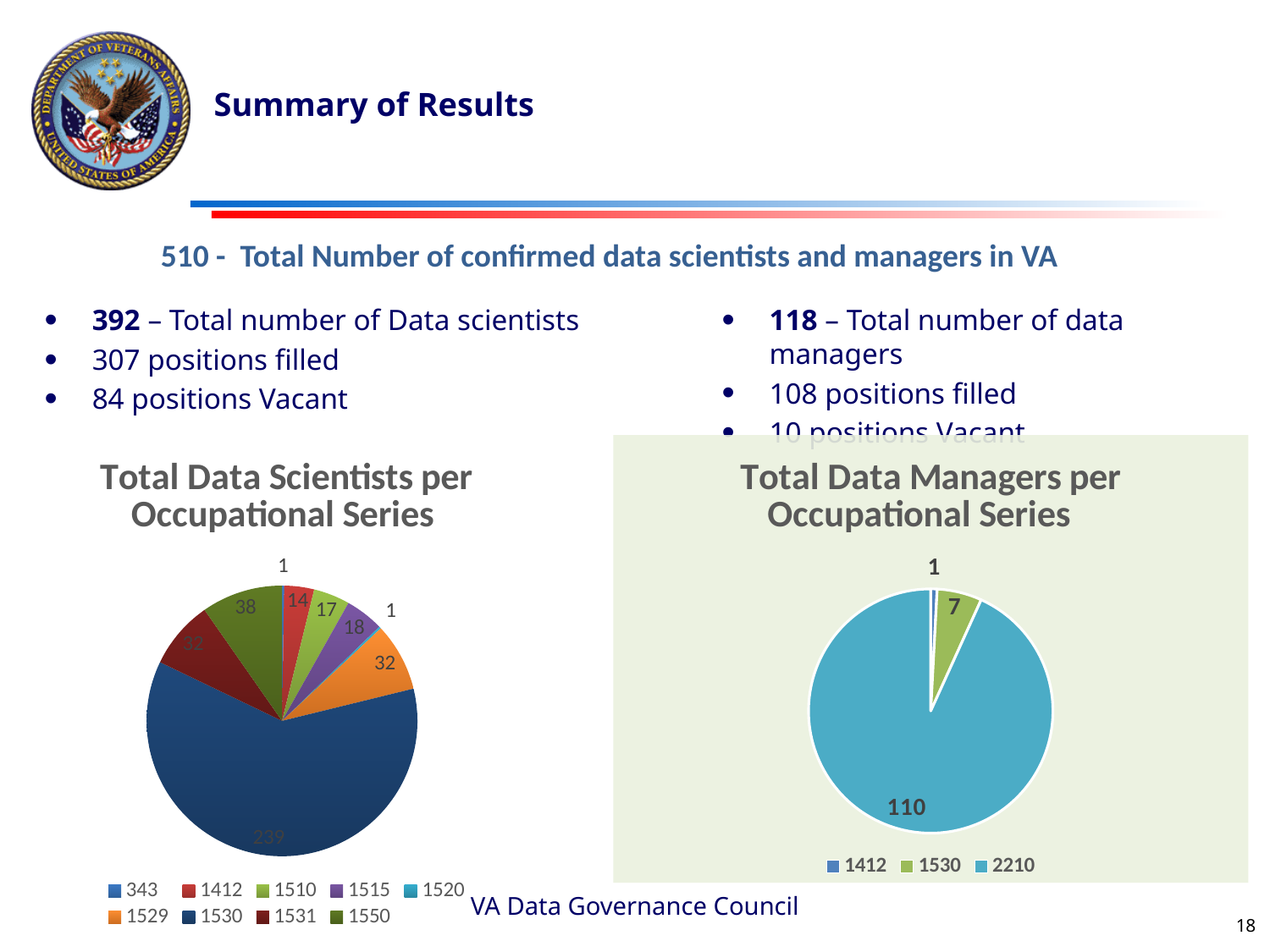
What is the title of the chart on the right side of the slide? Total Data Managers per Occupational Series In the Total Data Scientists per Occupational Series chart, which is larger, the value for series 1515 or series 1510? 1515 In the Total Data Scientists per Occupational Series chart, what is the value for series 1530? 239 In the Total Data Managers per Occupational Series chart, what is the value for series 2210? 110 In the Total Data Managers per Occupational Series chart, which occupational series has the smallest slice? 1412 What is the total of all slices in the Total Data Managers per Occupational Series chart? 118 What type of chart is the Total Data Managers per Occupational Series chart? Pie chart In the Total Data Managers per Occupational Series chart, what is the value for series 1412? 1 How many entries does the legend of the Total Data Managers per Occupational Series chart list? 3 How many occupational series are shown in the Total Data Scientists per Occupational Series chart? 9 In the Total Data Scientists per Occupational Series chart, what is the difference between the values for series 1550 and series 1529? 6 In the Total Data Scientists per Occupational Series chart, which occupational series has the largest slice? 1530